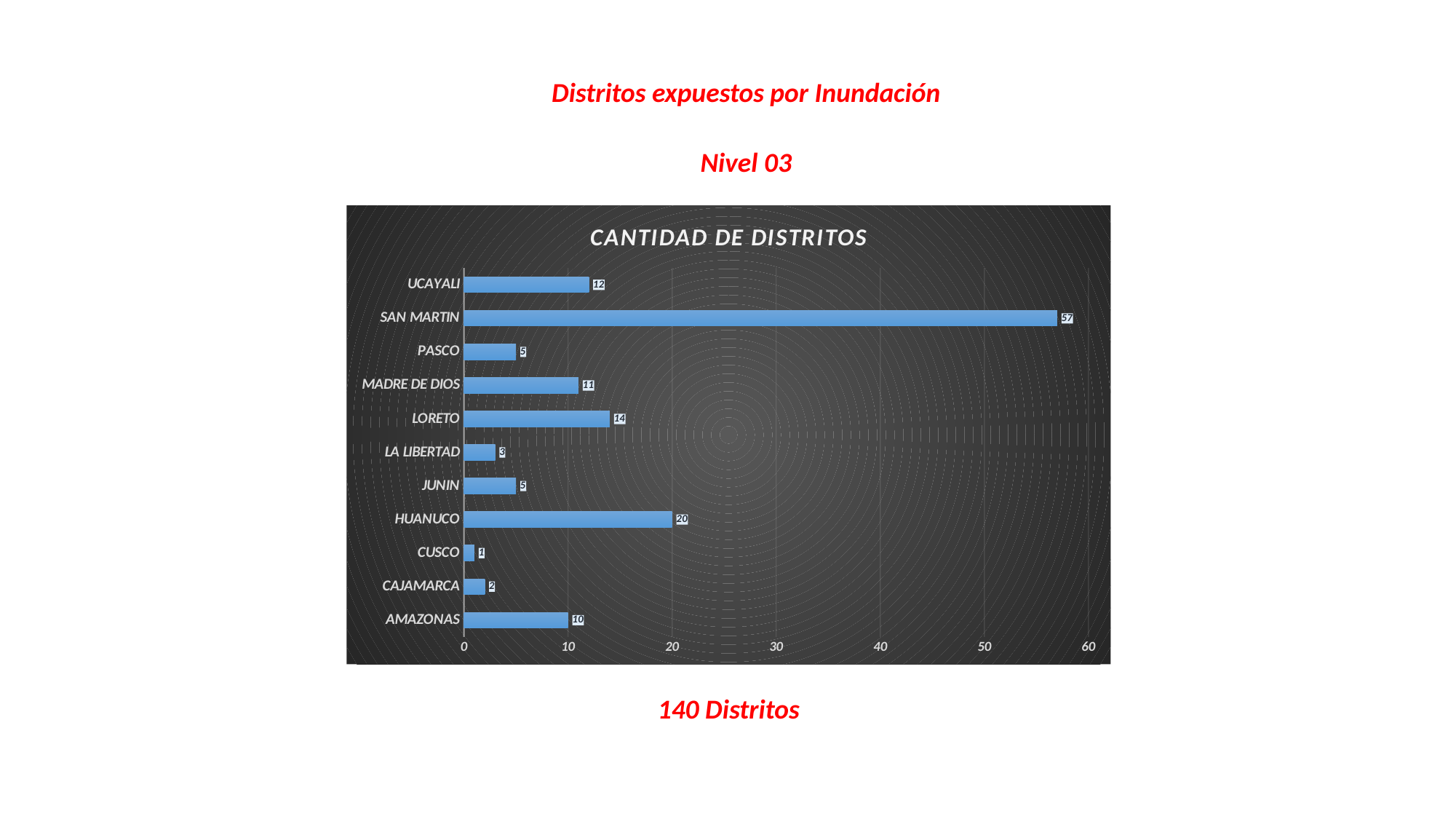
How many categories are shown in the chart? 11 What is the difference between the values for LORETO and LA LIBERTAD? 11 Which category has the highest value? SAN MARTIN What kind of chart is shown? bar chart What is the value for HUANUCO? 20 Is the value for AMAZONAS greater or less than 20? less What is the title of the chart? CANTIDAD DE DISTRITOS What is the value for MADRE DE DIOS? 11 What is the value for SAN MARTIN? 57 Which category has the lowest value? CUSCO Which is larger, the value for LORETO or the value for UCAYALI? LORETO What is the difference between the values for SAN MARTIN and HUANUCO? 37